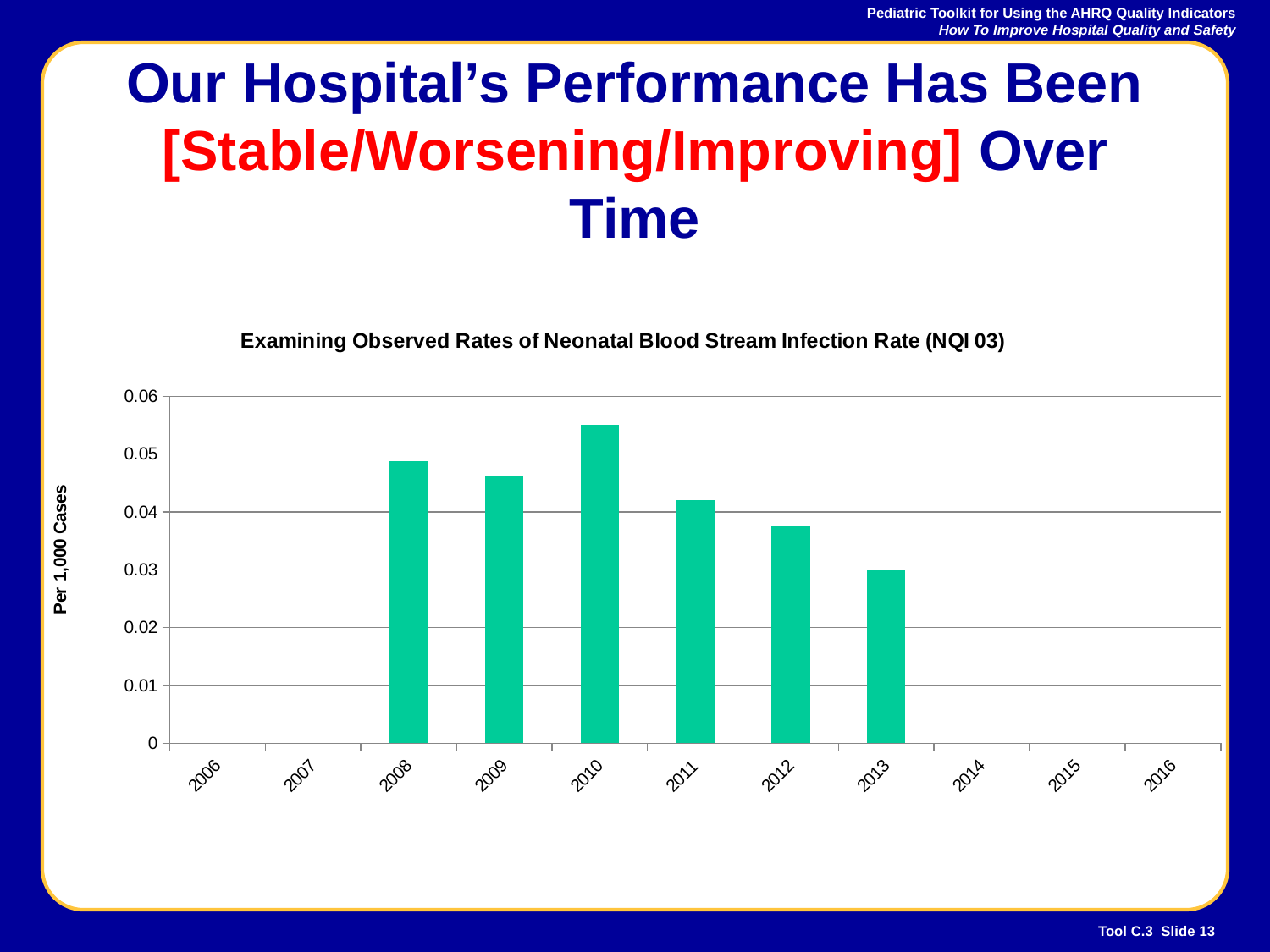
What is the label on the vertical axis of the chart? Per 1,000 Cases Is the value for 2012 greater or less than 0.04? less What kind of chart is shown on the slide? bar chart How many year labels are shown on the x axis of the chart? 11 What is the title of the chart? Examining Observed Rates of Neonatal Blood Stream Infection Rate (NQI 03) Which year has the larger value, 2010 or 2011? 2010 How many years have bars plotted in the chart? 6 Do the values rise or fall from 2010 to 2013? fall Is the value for 2010 greater or less than 0.05? greater Which year has the highest observed rate in the chart? 2010 Is the value for 2011 greater or less than 0.04? greater Among the years with bars plotted, which year has the lowest observed rate? 2013